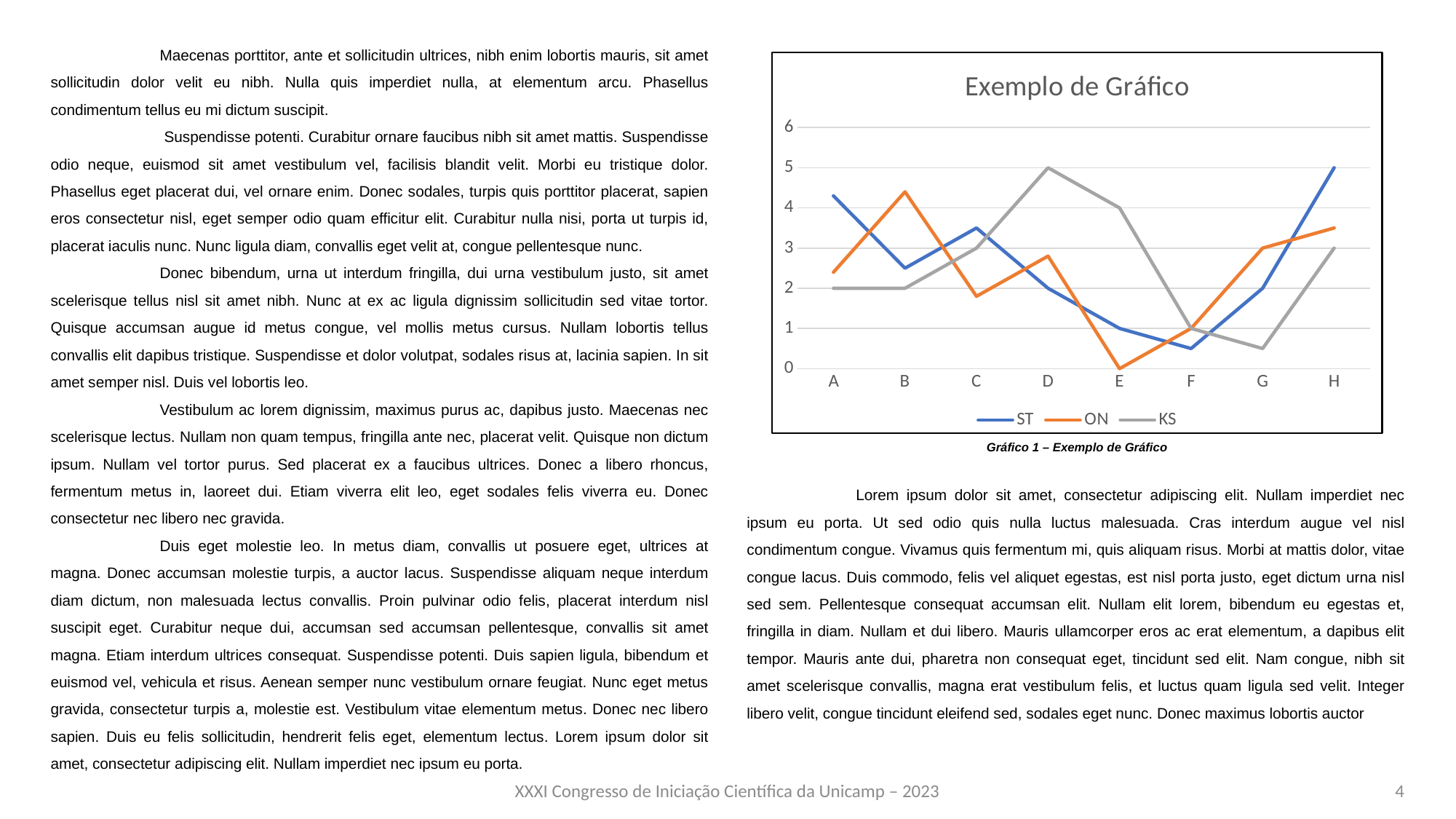
Is the value of the ST series at category A greater or less than 4? greater At which category does the ON series reach its lowest value? E At which category does the ST series reach its highest value? H What is the value of the ON series at category E? 0 At which category does the KS series reach its highest value? D What kind of chart is shown on the slide? line chart Which series in the chart is drawn in orange? ON What is the title of the chart? Exemplo de Gráfico How many categories are shown on the x axis of the chart? 8 At category B, which series has the larger value, ST or ON? ON How many series does the legend of the chart list? 3 What is the value of the KS series at category D? 5